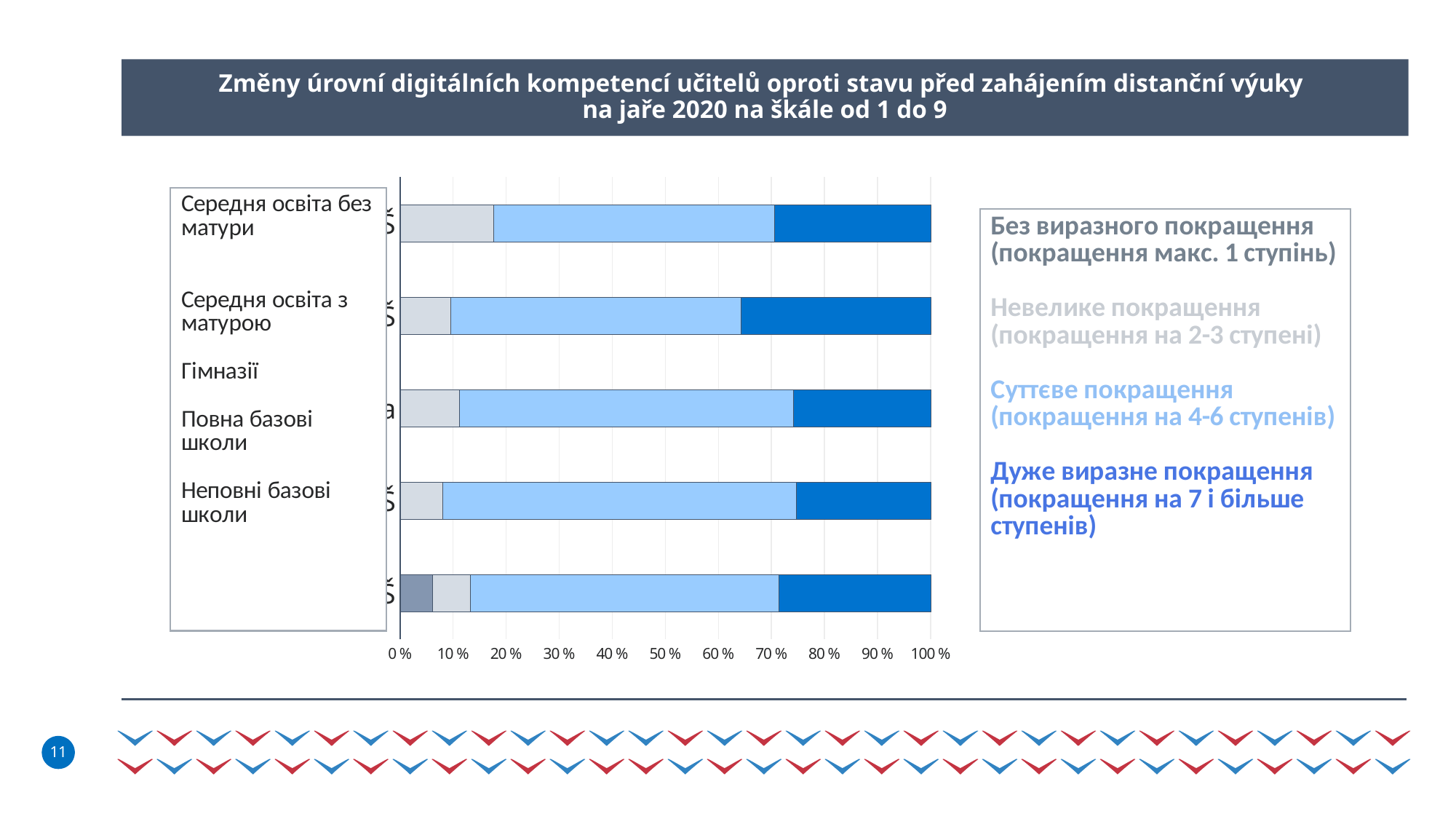
Is the dark blue segment larger in the top bar or in the second bar from the top? the second bar from the top Which bar has the largest dark blue segment ("Дуже виразне покращення")? the second bar from the top In the top bar, does the light blue segment ("Суттєве покращення") end at a value greater or less than 60%? greater How many entries does the legend on the right of the chart list? 4 Which colour represents the legend entry "Дуже виразне покращення (покращення на 7 і більше ступенів)"? dark blue How many bars does the chart contain? 5 What is the title of the slide above the chart? Změny úrovní digitálních kompetencí učitelů oproti stavu před zahájením distanční výuky na jaře 2020 na škále od 1 do 9 In the bottom bar, is the dark grey segment at the start greater or less than 10%? less What kind of chart is shown on the slide? stacked bar chart In the second bar from the top, does the light blue segment end at a value greater or less than 70%? less